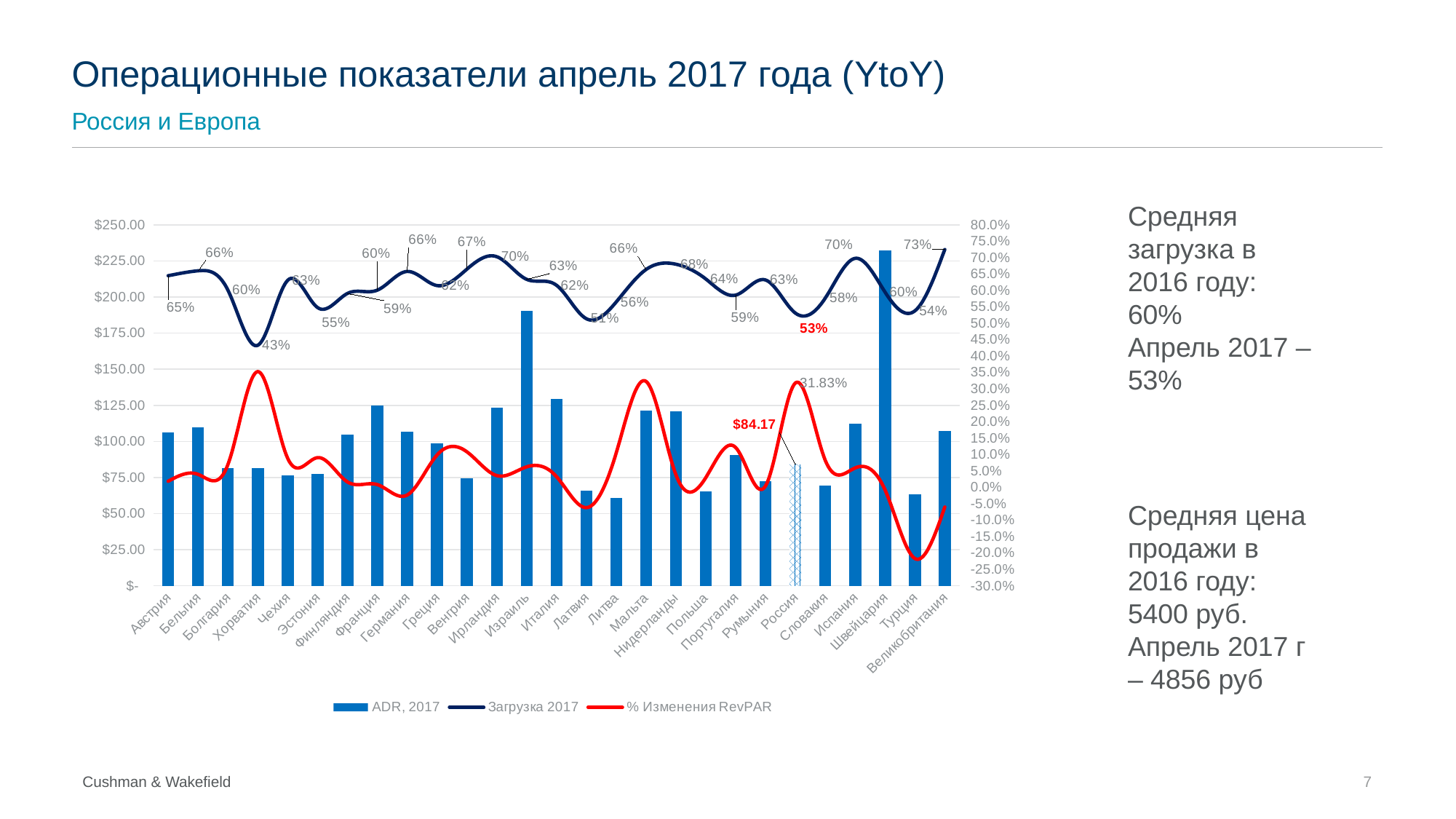
What is the ADR, 2017 value labelled for Россия? $84.17 Which country has the highest Загрузка 2017 value? Великобритания How many series does the chart legend list? 3 Which country has the lowest Загрузка 2017 value? Хорватия Is the ADR, 2017 value for Швейцария greater or less than $225.00? greater What is the difference between the Загрузка 2017 values for Великобритания and Хорватия? 30 percentage points How many countries are shown on the x axis of the chart? 27 Which has the higher Загрузка 2017 value, Ирландия or Россия? Ирландия What kind of chart is shown on the slide? Combined bar and line chart What is the % Изменения RevPAR value labelled for Россия? 31.83% What is the occupancy (Загрузка 2017) value shown for Хорватия? 43% What is the occupancy (Загрузка 2017) value shown for Россия? 53%